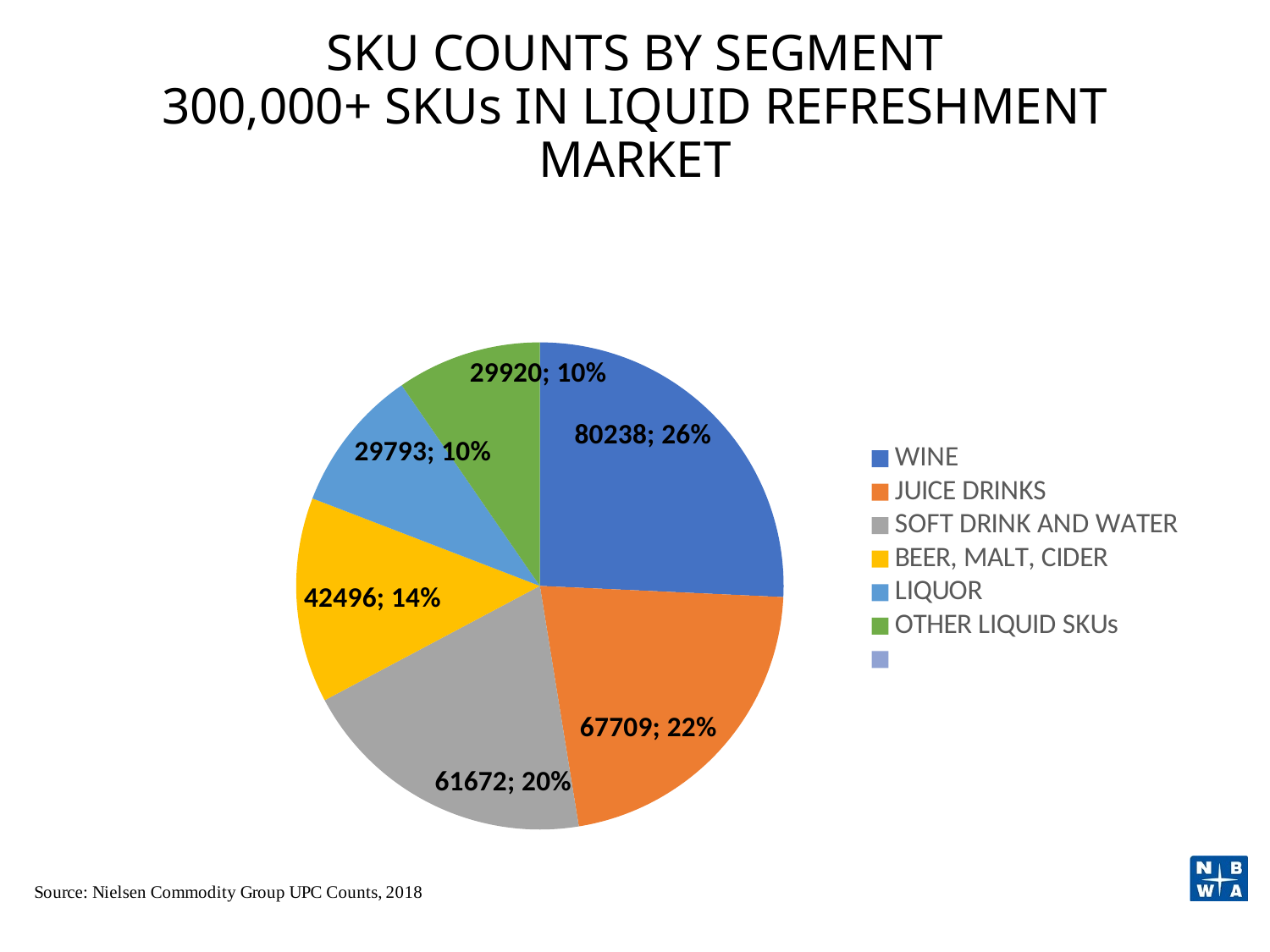
What kind of chart is shown on the slide? pie chart What is the difference in SKU count between WINE and JUICE DRINKS? 12529 What is the SKU count for SOFT DRINK AND WATER? 61672 How many slices does the pie chart have? 6 Which segment has the lowest SKU count? LIQUOR What is the SKU count for BEER, MALT, CIDER? 42496 What share of the pie does WINE represent? 26% What share of the pie does BEER, MALT, CIDER represent? 14% Which segment has the highest SKU count? WINE What is the SKU count for JUICE DRINKS? 67709 What is the SKU count for LIQUOR? 29793 What is the SKU count for WINE? 80238